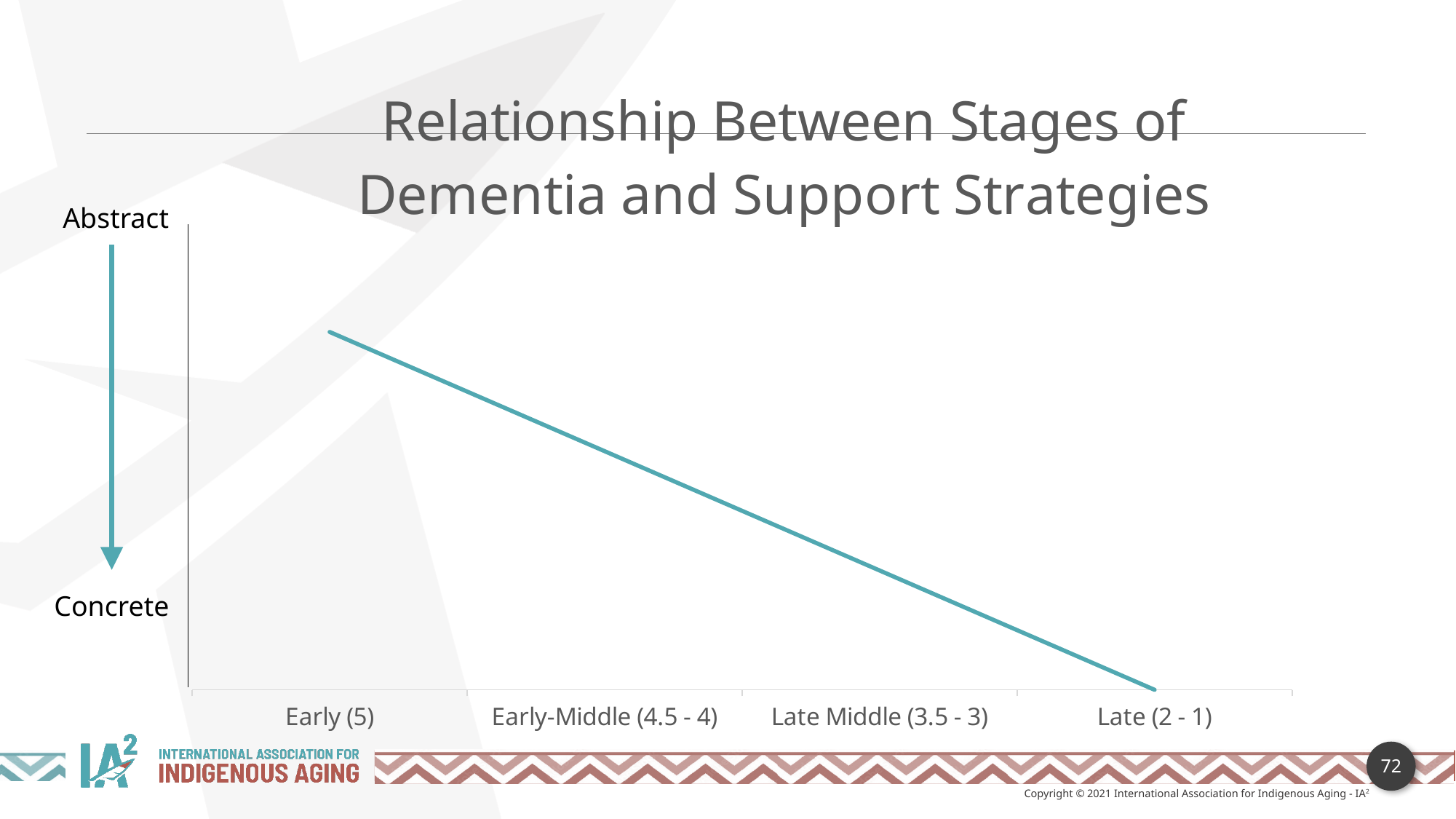
Which is higher on the line, Early-Middle (4.5 - 4) or Late Middle (3.5 - 3)? Early-Middle (4.5 - 4) Does the line rise or fall as it moves from Early (5) to Late (2 - 1)? Falls Which stage has the highest point on the line? Early (5) What is the title of the chart? Relationship Between Stages of Dementia and Support Strategies What kind of chart is shown on the slide? Line chart What is the label of the third category on the x axis? Late Middle (3.5 - 3) Which stage has the lowest point on the line? Late (2 - 1) How many stages of dementia are labelled along the x axis? 4 What are the two labels at the top and bottom of the vertical axis? Abstract and Concrete Which is higher on the line, Early (5) or Late (2 - 1)? Early (5)